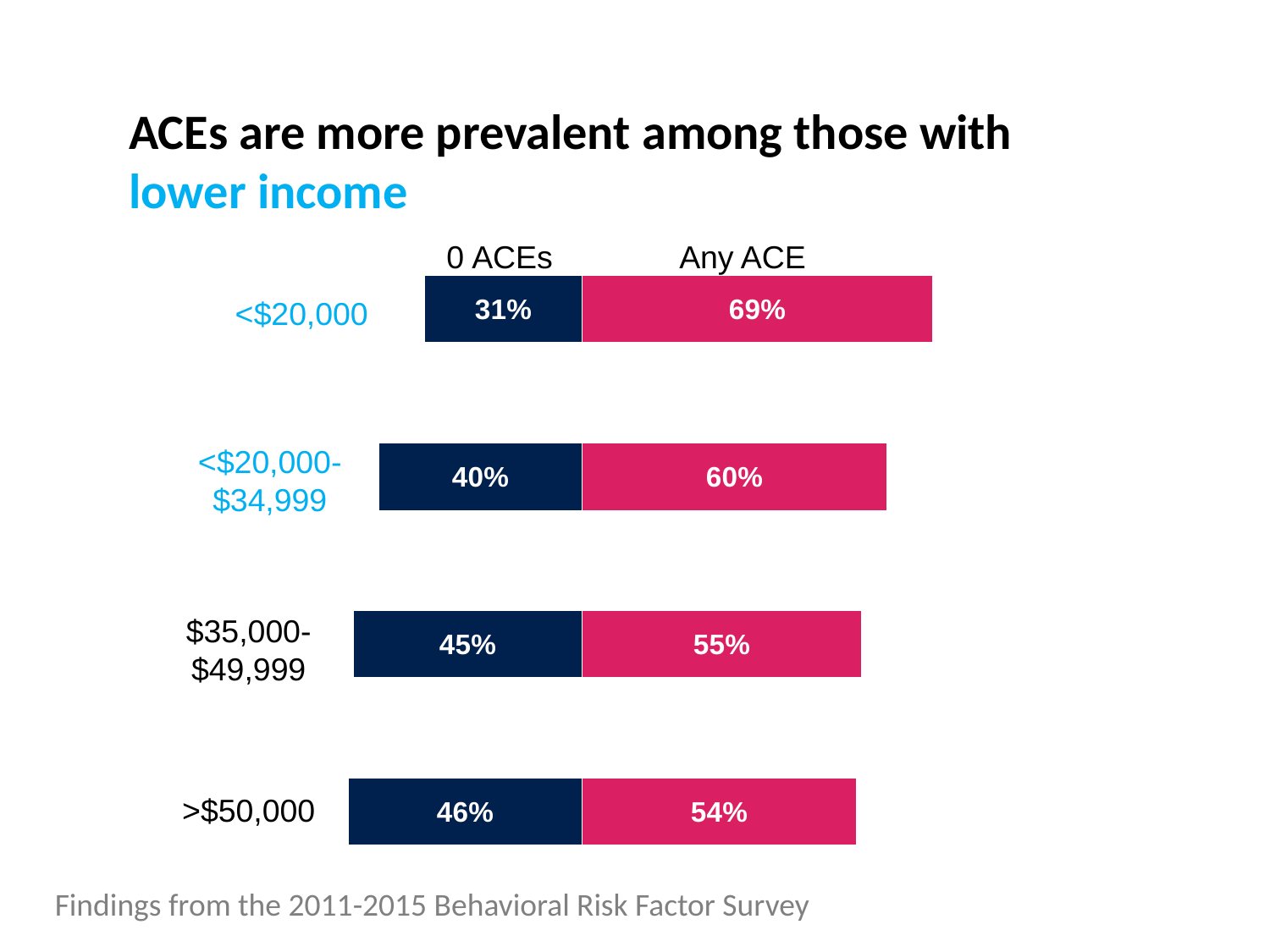
How many series does the chart show? 2 What percentage of those with income <$20,000 have Any ACE? 69% What colour represents the Any ACE series? Pink How many income groups are shown in the chart? 4 Which income group has the lowest 0 ACEs percentage? <$20,000 What is the difference between the Any ACE percentages for the <$20,000 group and the >$50,000 group? 15% What is the Any ACE value for the $35,000-$49,999 income group? 55% What percentage of those with income >$50,000 have 0 ACEs? 46% What kind of chart is shown on the slide? Stacked bar chart Which is larger: the 0 ACEs value for <$20,000-$34,999 or the 0 ACEs value for $35,000-$49,999? $35,000-$49,999 What is the total of the 0 ACEs and Any ACE values for the <$20,000-$34,999 group? 100% Which income group has the highest Any ACE percentage? <$20,000